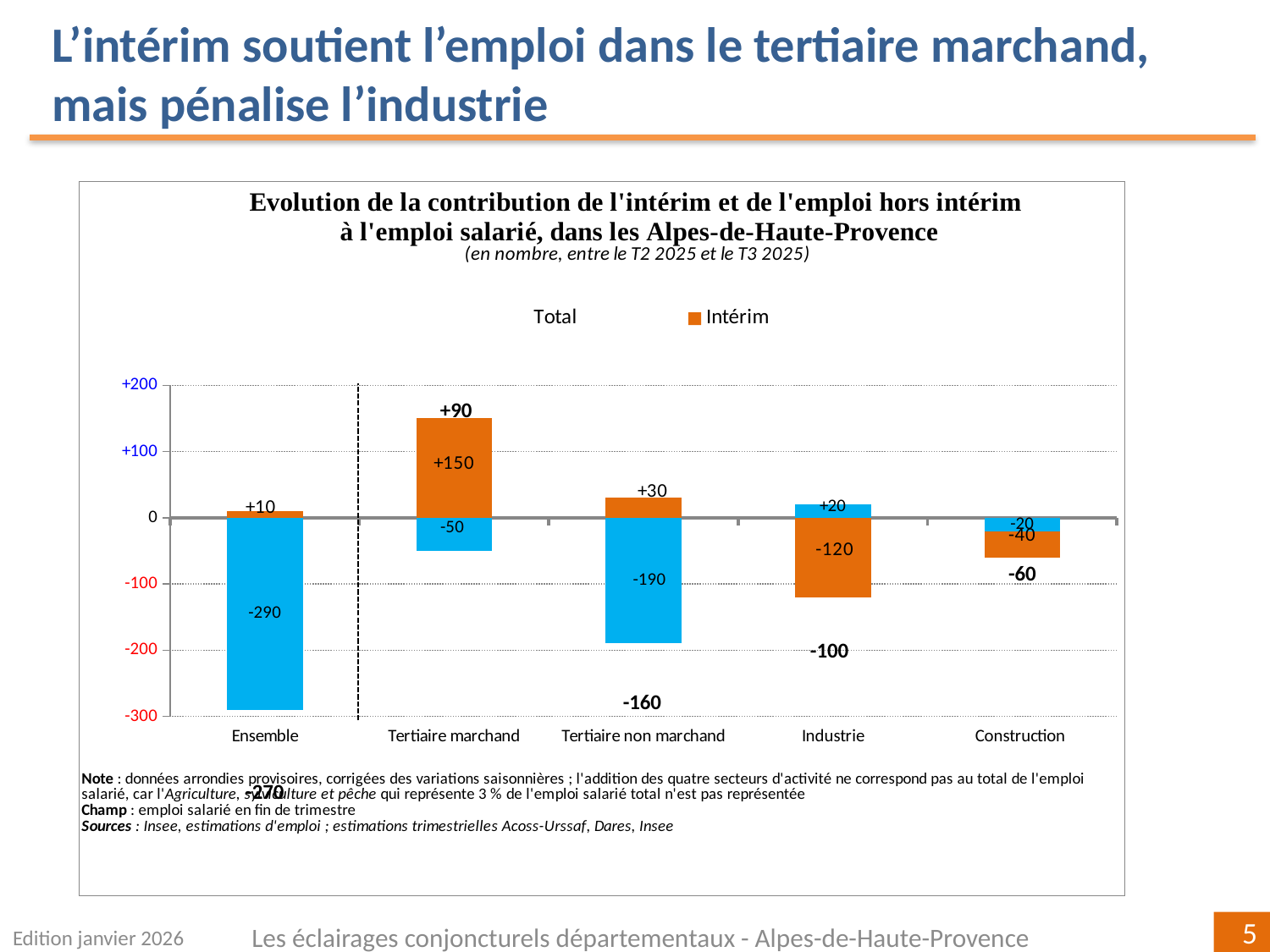
What kind of chart is shown on the slide? Bar chart What is the difference between the Intérim value for Tertiaire marchand (+150) and the Intérim value for Ensemble (+10)? 140 Which of the four sectors has the lowest total value? Tertiaire non marchand What is the total value shown for Construction? -60 How many series does the chart legend list? 2 Which of the four sectors has the highest total value? Tertiaire marchand How many categories are shown on the x axis of the chart? 5 What is the total value shown for Tertiaire non marchand? -160 What is the Intérim value for Industrie? -120 What is the Intérim value for Tertiaire marchand? +150 Which has the larger Intérim value, Tertiaire marchand or Industrie? Tertiaire marchand What colour represents the Intérim series in the legend? Orange